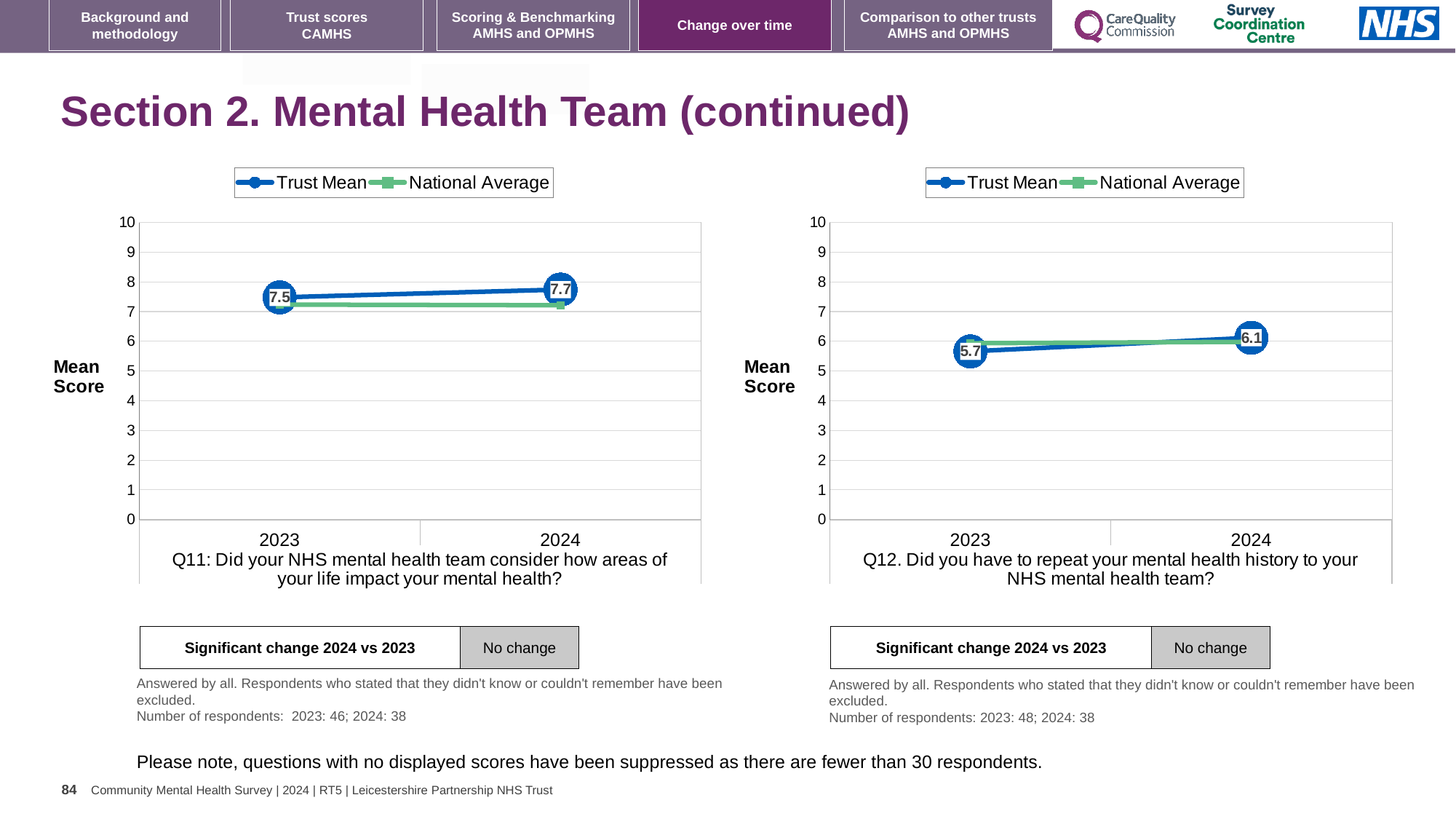
In the Q11 chart on the left, what is the Trust Mean for 2023? 7.5 In the Q11 chart on the left, is the National Average for 2024 greater or less than 8? less In the Q12 chart on the right, what is the Trust Mean for 2023? 5.7 How many series does the legend of the Q12 chart on the right list? 2 In the Q11 chart on the left, what is the Trust Mean for 2024? 7.7 In the Q12 chart on the right, what is the difference between the Trust Mean in 2024 and in 2023? 0.4 In the Q11 chart on the left, which year has the higher Trust Mean, 2023 or 2024? 2024 How many years are plotted on the x axis of the Q12 chart on the right? 2 In the Q12 chart on the right, does the Trust Mean rise or fall from 2023 to 2024? rise What kind of chart is the Q11 chart on the left? line chart In the Q11 chart on the left, by how much did the Trust Mean change from 2023 to 2024? 0.2 In the Q12 chart on the right, what is the Trust Mean for 2024? 6.1